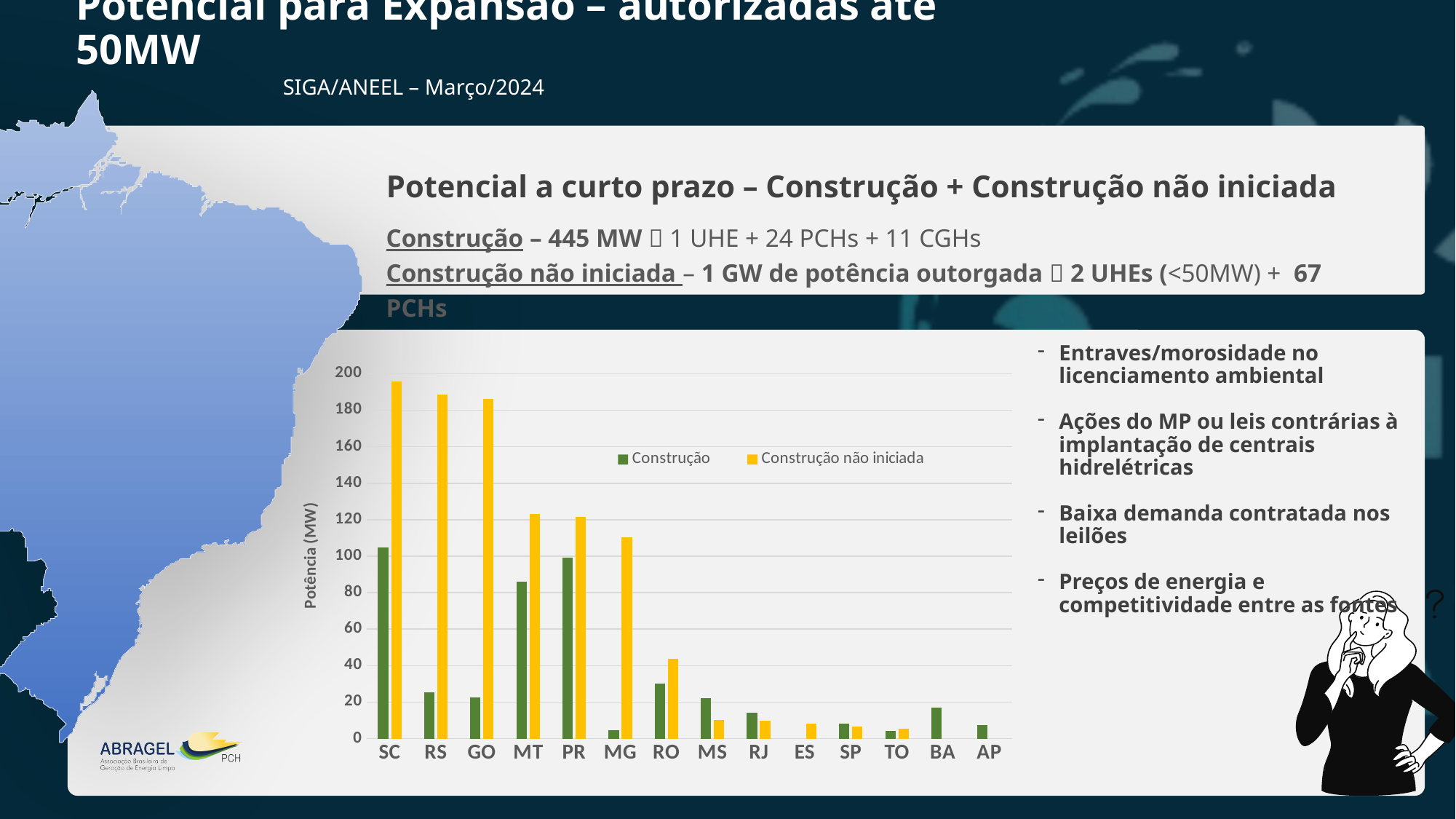
Which state has the highest 'Construção não iniciada' value in the chart? SC What kind of chart is shown on the slide? bar chart Do the 'Construção não iniciada' values generally rise or fall from SC on the left to AP on the right? fall How many series does the chart's legend list? 2 Is the 'Construção não iniciada' value for SC greater or less than 180? greater For RO, which series has the larger value, 'Construção' or 'Construção não iniciada'? Construção não iniciada Which colour represents the 'Construção não iniciada' series in the chart? yellow Is the 'Construção' value for MG greater or less than 20? less How many state categories are shown on the x axis of the chart? 14 Is the 'Construção' value for MT greater or less than 80? greater What is the label of the vertical axis of the chart? Potência (MW)